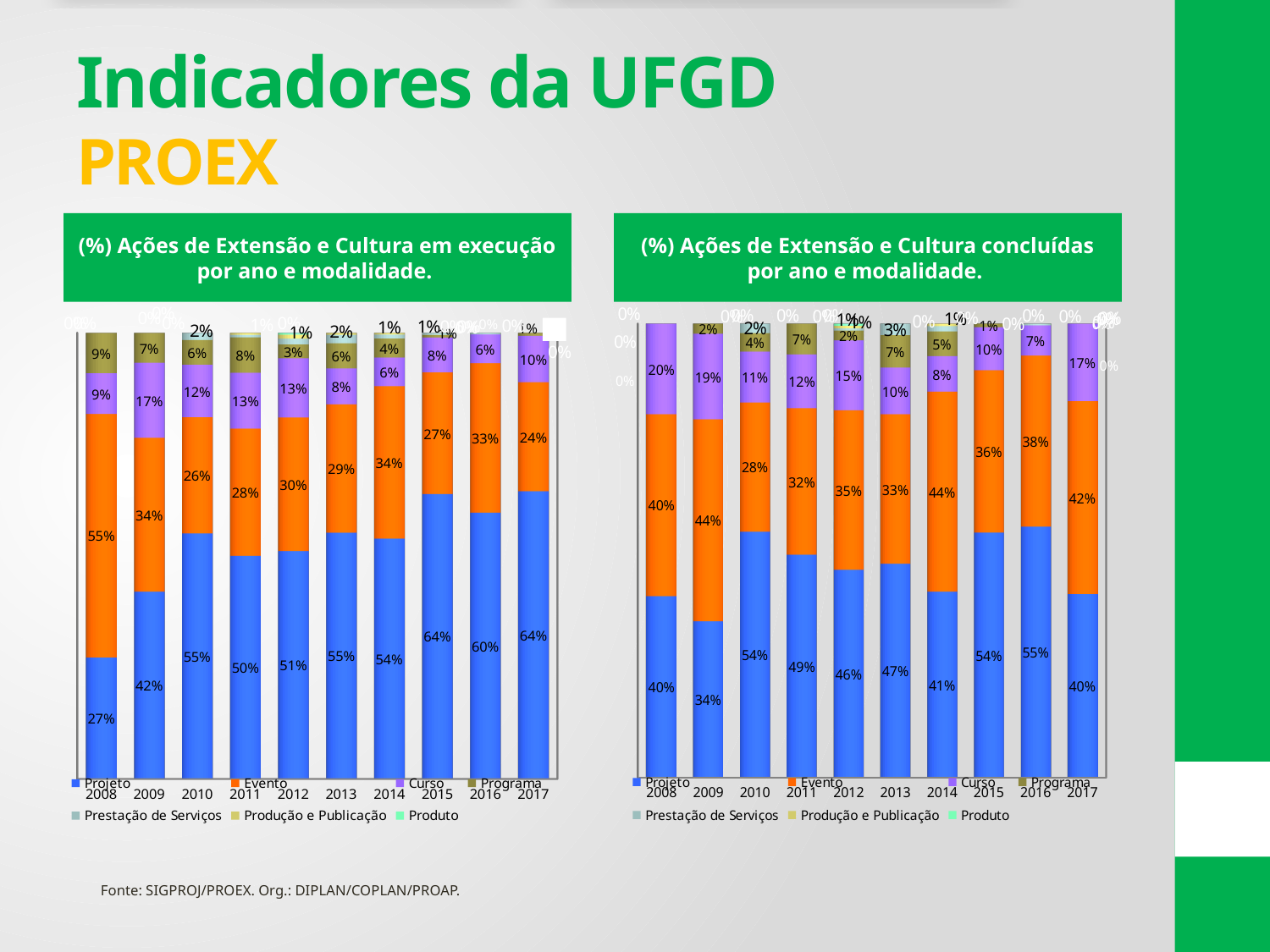
What kind of chart is "(%) Ações de Extensão e Cultura em execução por ano e modalidade"? Stacked bar chart How many years are shown on the x axis of the chart "(%) Ações de Extensão e Cultura em execução por ano e modalidade"? 10 In the chart "(%) Ações de Extensão e Cultura concluídas por ano e modalidade", which is larger in 2017, Projeto or Evento? Evento How many series does the legend of the chart "(%) Ações de Extensão e Cultura concluídas por ano e modalidade" list? 7 In the chart "(%) Ações de Extensão e Cultura em execução por ano e modalidade", what is the difference between the Projeto values for 2017 and 2008? 37 percentage points In the chart "(%) Ações de Extensão e Cultura concluídas por ano e modalidade", what is the value for Evento in 2014? 44% In the chart "(%) Ações de Extensão e Cultura em execução por ano e modalidade", which year has the lowest value for Projeto? 2008 In the chart "(%) Ações de Extensão e Cultura concluídas por ano e modalidade", which year has the highest value for Projeto? 2016 In the chart "(%) Ações de Extensão e Cultura concluídas por ano e modalidade", what is the value for Curso in 2008? 20% In the chart "(%) Ações de Extensão e Cultura em execução por ano e modalidade", what is the value for Projeto in 2008? 27% In the chart "(%) Ações de Extensão e Cultura em execução por ano e modalidade", what is the value for Evento in 2016? 33% In the chart "(%) Ações de Extensão e Cultura concluídas por ano e modalidade", which series is shown in orange? Evento